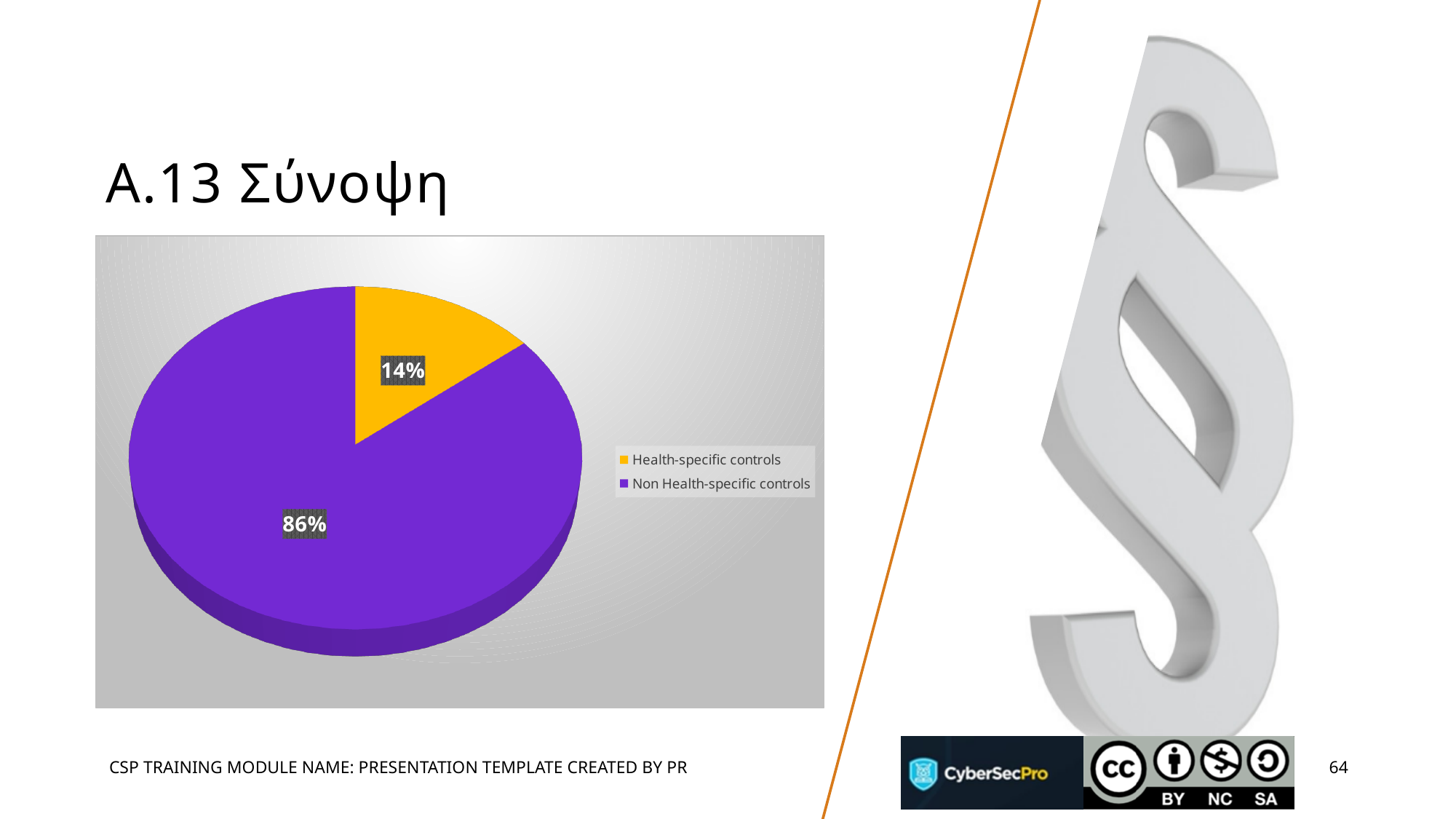
How many slices does the pie chart have? 2 What colour is the slice for Non Health-specific controls? Purple Which is larger: the share for Health-specific controls or for Non Health-specific controls? Non Health-specific controls What share of the pie does the Non Health-specific controls slice represent? 86% Which category has the smallest share of the pie chart? Health-specific controls What colour is the slice for Health-specific controls? Yellow Which category has the largest share of the pie chart? Non Health-specific controls What percentage of the pie chart is Non Health-specific controls? 86% What percentage of the pie chart is Health-specific controls? 14% What is the difference in percentage points between Non Health-specific controls and Health-specific controls? 72 How many entries does the legend list? 2 What kind of chart is shown on the slide? Pie chart